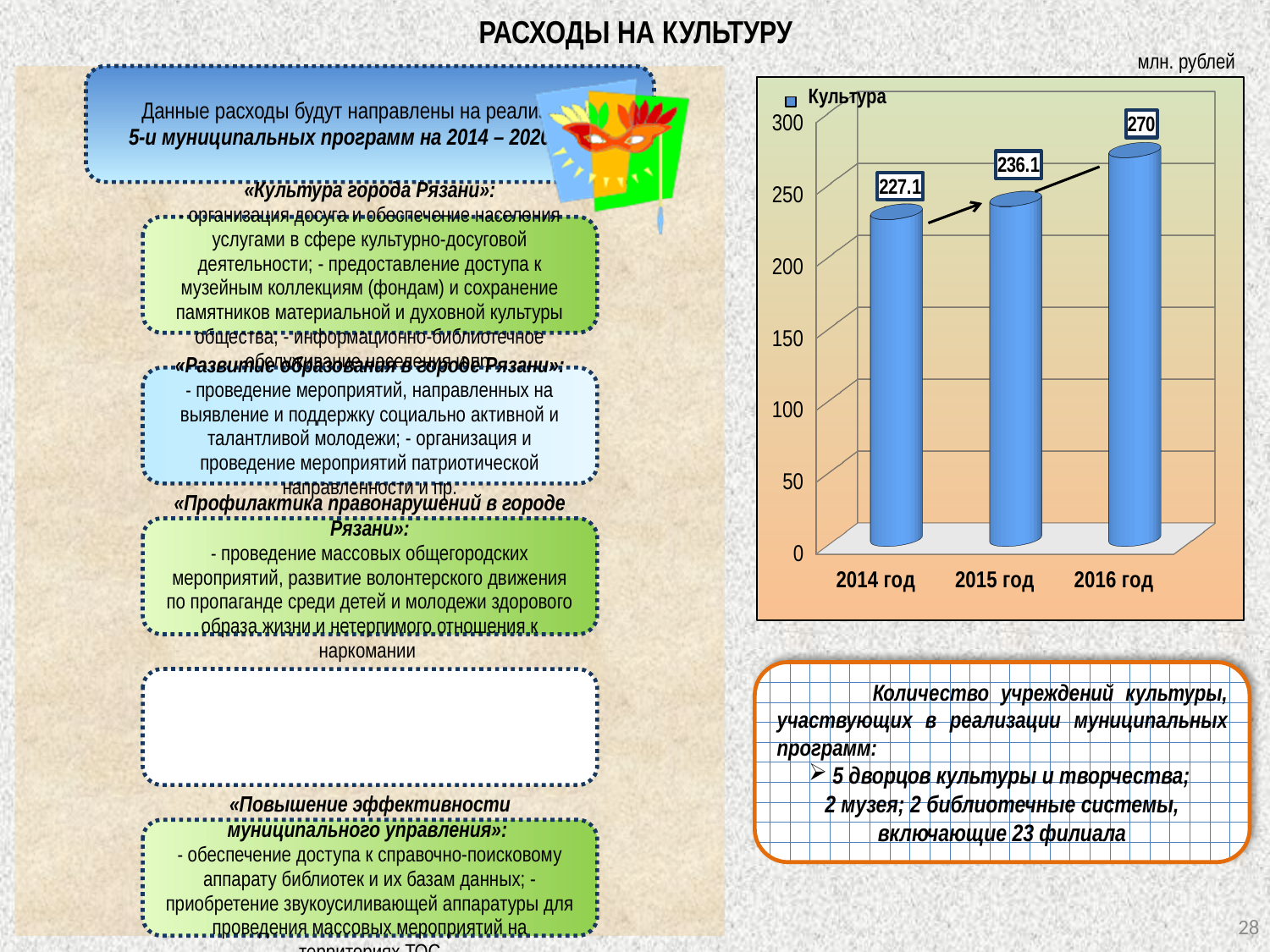
Is the value for 2014 год greater or less than 250? less Which year has the highest value in the chart? 2016 год Which is larger, the value for 2015 год or the value for 2016 год? 2016 год Do the values rise or fall from 2014 год to 2016 год? rise What kind of chart is shown on the slide? bar chart What is the value for 2014 год in the chart? 227.1 How many years are shown on the x axis of the chart? 3 What is the difference between the values for 2016 год and 2014 год? 42.9 What is the value for 2015 год in the chart? 236.1 What is the difference between the values for 2015 год and 2014 год? 9 What is the value for 2016 год in the chart? 270 Which year has the lowest value in the chart? 2014 год